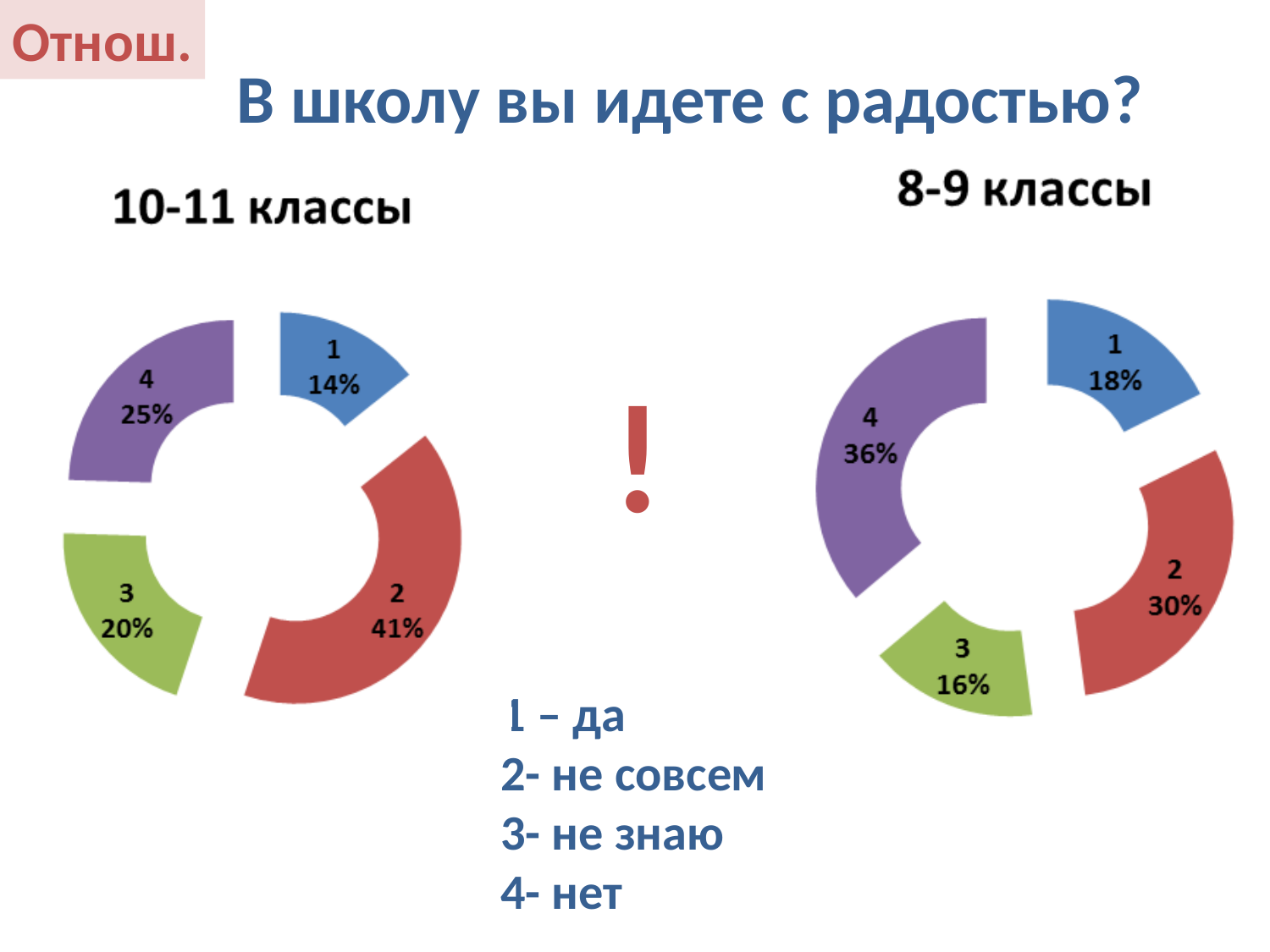
In the "10-11 классы" chart, which category has the smallest share? 1 In the "8-9 классы" chart, what percentage is shown for category 4? 36% What type of chart is the "10-11 классы" chart? Doughnut chart In the "8-9 классы" chart, which category has the largest share? 4 In the "10-11 классы" chart, what percentage is shown for category 1? 14% In the "8-9 классы" chart, what percentage is shown for category 3? 16% In the "10-11 классы" chart, which category has the largest share? 2 In the "8-9 классы" chart, which category has the smallest share? 3 Which is larger: category 2 in the "10-11 классы" chart or category 2 in the "8-9 классы" chart? 10-11 классы In the "10-11 классы" chart, what percentage is shown for category 2? 41% How many categories does the "8-9 классы" chart show? 4 What is the difference between the shares of category 2 and category 4 in the "10-11 классы" chart? 16%